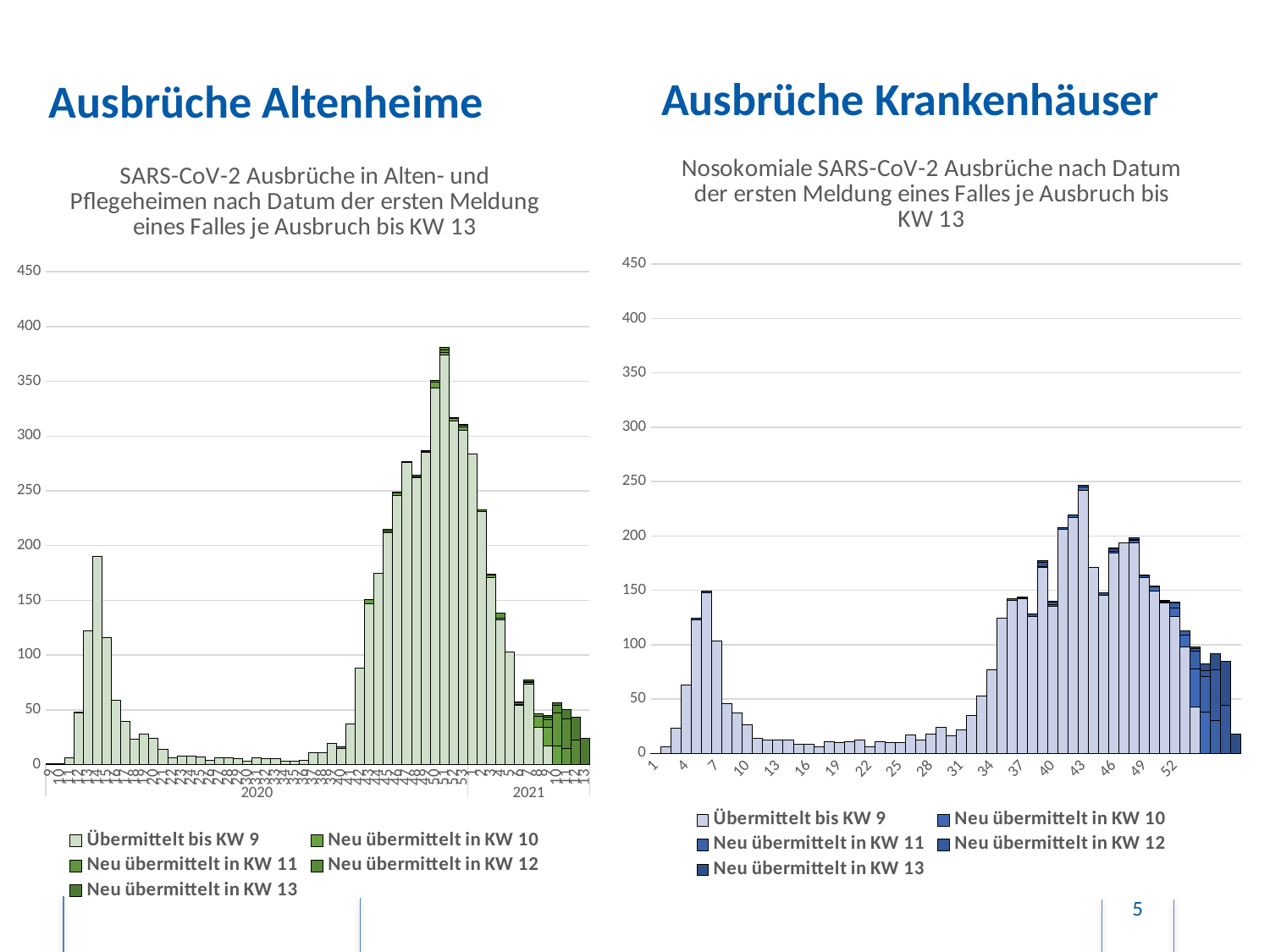
In the left chart (Alten- und Pflegeheime), is the value of the tallest bar greater or less than 400? less What kind of chart is the 'Ausbrüche Krankenhäuser' chart on the right? bar chart What is the first legend entry of the right chart (Nosokomiale Ausbrüche)? Übermittelt bis KW 9 In the right chart (Nosokomiale Ausbrüche), is the value for week 4 greater or less than 100? less What kind of chart is the 'Ausbrüche Altenheime' chart on the left? bar chart In the left chart (Alten- und Pflegeheime), is the value of the tallest bar greater or less than 350? greater How many series does the legend of the left chart (Alten- und Pflegeheime) list? 5 What is the highest value shown on the y axis of the left chart (Alten- und Pflegeheime)? 450 How many series does the legend of the right chart (Nosokomiale Ausbrüche) list? 5